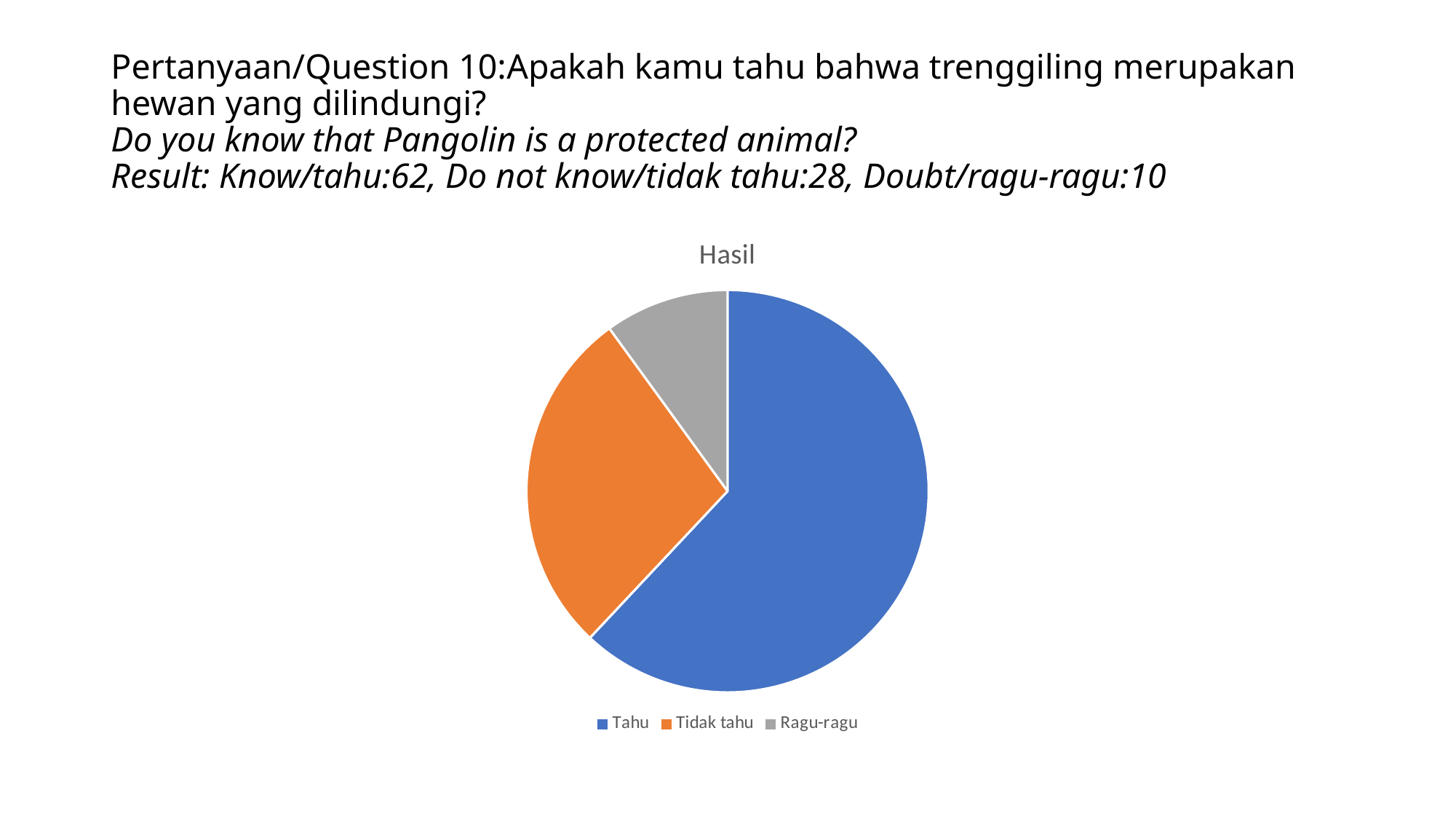
What kind of chart is shown on the slide? pie chart What is the value for Ragu-ragu? 10 What is the title of the chart? Hasil Which category has the largest slice of the pie? Tahu What share of the pie does Tahu represent? 62% What is the difference between the values for Tahu and Tidak tahu? 34 How many slices does the pie chart have? 3 Which is larger, the slice for Tidak tahu or the slice for Ragu-ragu? Tidak tahu What is the value for Tidak tahu? 28 What is the value for Tahu? 62 Which category has the smallest slice of the pie? Ragu-ragu How many entries does the chart legend list? 3